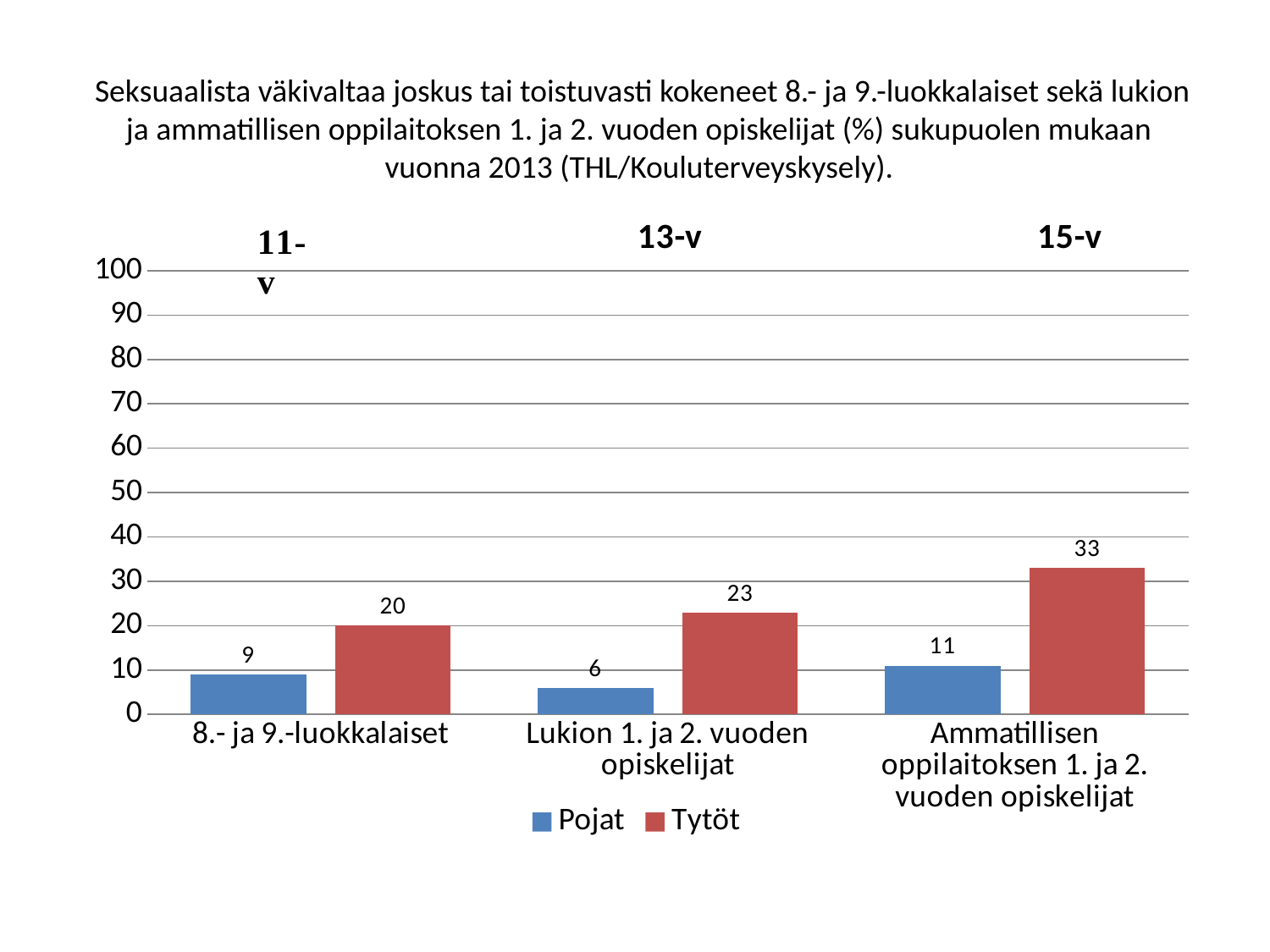
How many series does the legend list? 2 How many categories are shown on the x axis? 3 What colour are the Tytöt bars? red Is the value for Tytöt among Ammatillisen oppilaitoksen 1. ja 2. vuoden opiskelijat greater or less than 30? greater Which category has the lowest value for Pojat? Lukion 1. ja 2. vuoden opiskelijat What is the value for Tytöt among Lukion 1. ja 2. vuoden opiskelijat? 23 Which category has the highest value for Tytöt? Ammatillisen oppilaitoksen 1. ja 2. vuoden opiskelijat Which is larger among 8.- ja 9.-luokkalaiset: Pojat or Tytöt? Tytöt What is the value for Tytöt among Ammatillisen oppilaitoksen 1. ja 2. vuoden opiskelijat? 33 What kind of chart is shown? bar chart What is the value for Pojat among 8.- ja 9.-luokkalaiset? 9 What is the difference between Tytöt and Pojat among Ammatillisen oppilaitoksen 1. ja 2. vuoden opiskelijat? 22